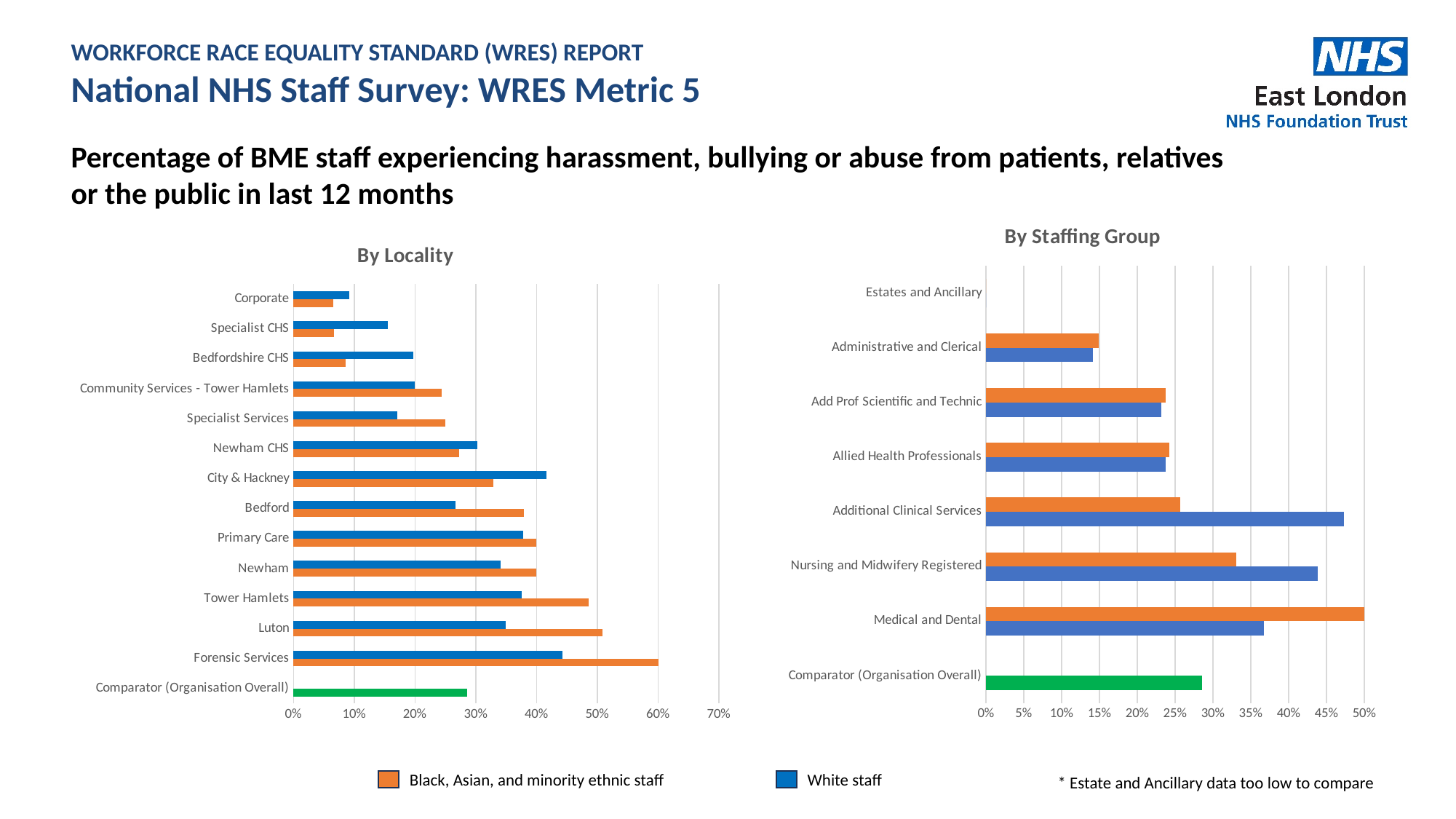
In the 'By Staffing Group' chart, is the value for White staff in Nursing and Midwifery Registered greater or less than 40%? greater How many categories are listed on the y axis of the 'By Locality' chart? 14 In the 'By Locality' chart, for City & Hackney, which is larger: the value for Black, Asian, and minority ethnic staff or the value for White staff? White staff How many series does the legend at the bottom of the slide list? 2 In the 'By Locality' chart, which locality has the highest value for Black, Asian, and minority ethnic staff? Forensic Services In the 'By Locality' chart, which locality has the lowest value for White staff? Corporate In the 'By Locality' chart, for Bedford, which is larger: the value for Black, Asian, and minority ethnic staff or the value for White staff? Black, Asian, and minority ethnic staff In the 'By Locality' chart, is the value for Black, Asian, and minority ethnic staff in Tower Hamlets greater or less than 40%? greater In the 'By Staffing Group' chart, which staffing group has the highest value for White staff? Additional Clinical Services What kind of chart is the 'By Locality' chart? bar chart In the 'By Locality' chart, is the value for Black, Asian, and minority ethnic staff in Forensic Services greater or less than 50%? greater In the 'By Staffing Group' chart, which staffing group has the highest value for Black, Asian, and minority ethnic staff? Medical and Dental